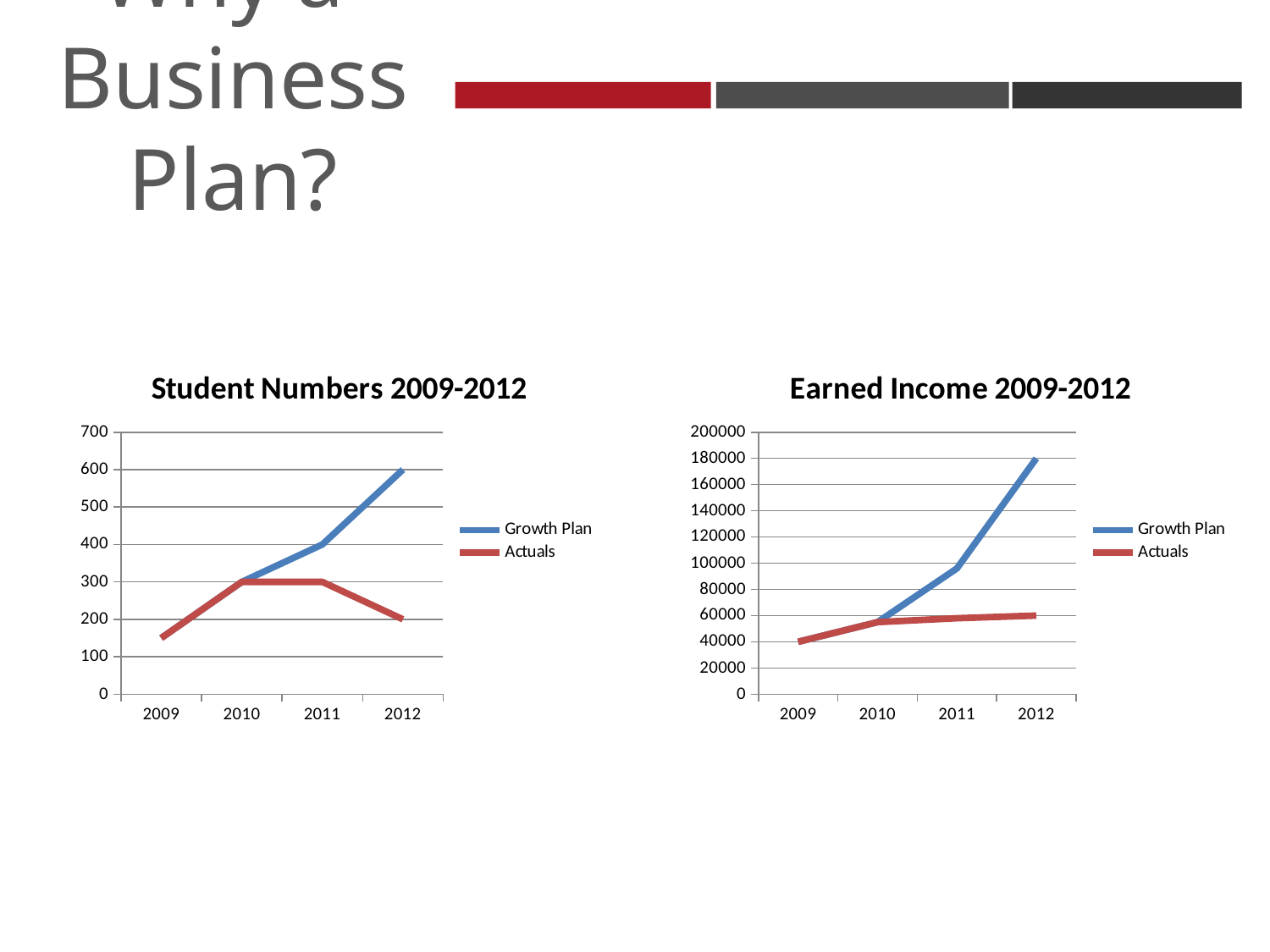
In the Earned Income 2009-2012 chart, what is the Actuals value for 2012? 60000 How many years are shown on the x axis of the Student Numbers 2009-2012 chart? 4 In the Earned Income 2009-2012 chart, which series is higher in 2012, Growth Plan or Actuals? Growth Plan In the Student Numbers 2009-2012 chart, what is the Actuals value for 2012? 200 In the Earned Income 2009-2012 chart, is the Growth Plan value for 2011 greater or less than 80000? greater In the Student Numbers 2009-2012 chart, which colour is used for the Actuals line? red In the Student Numbers 2009-2012 chart, what is the difference between Growth Plan and Actuals in 2012? 400 How many series does the legend of the Earned Income 2009-2012 chart list? 2 What type of chart is the Student Numbers 2009-2012 chart? line chart In the Student Numbers 2009-2012 chart, does the Actuals line rise or fall from 2011 to 2012? fall In the Earned Income 2009-2012 chart, what is the Growth Plan value for 2012? 180000 In the Student Numbers 2009-2012 chart, what is the Growth Plan value for 2012? 600